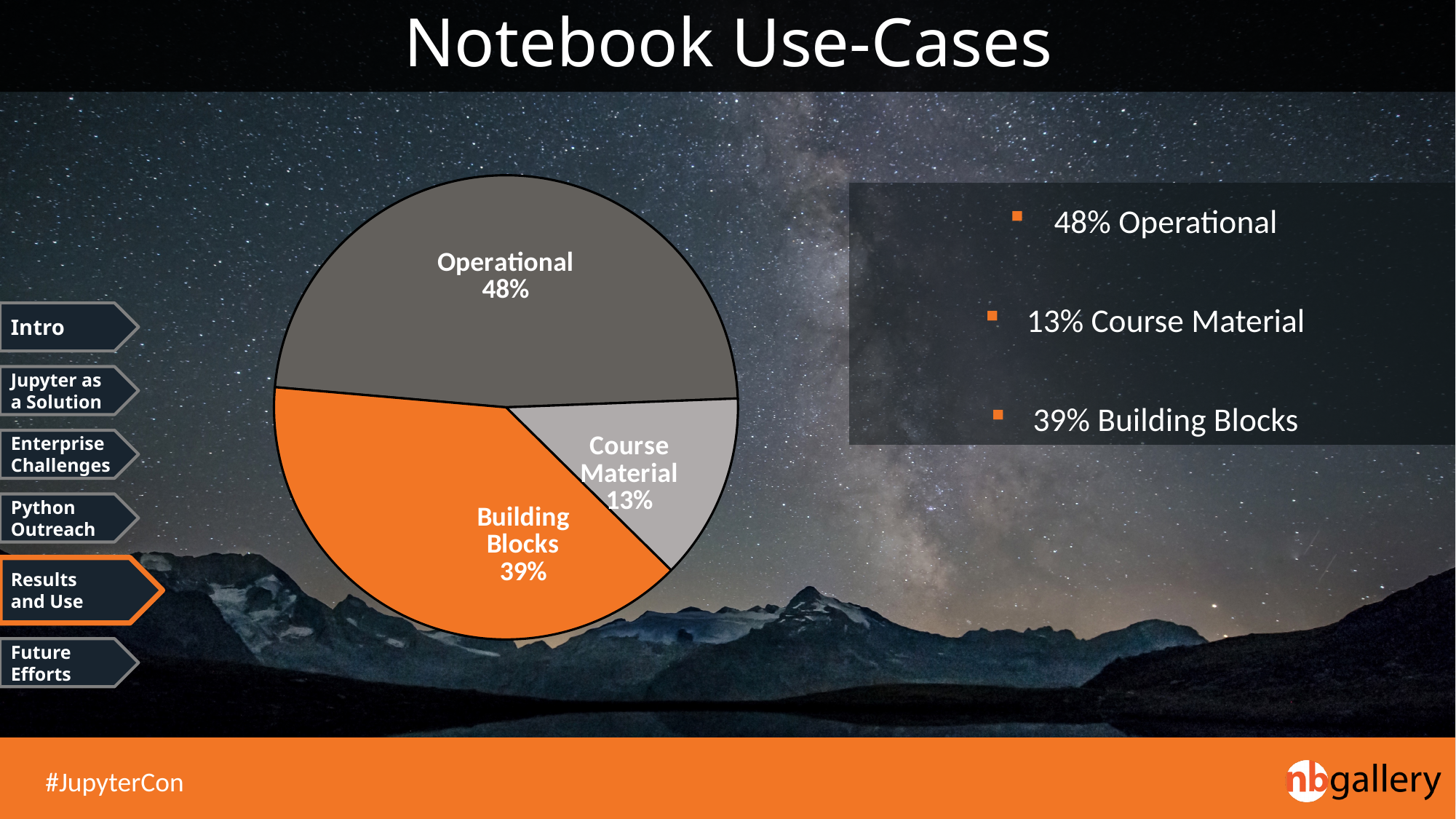
Which is larger, the Operational slice or the Building Blocks slice? Operational What is the difference in percentage points between Building Blocks and Course Material? 26 Which category has the largest slice of the pie? Operational How many slices does the pie chart have? 3 What colour is the Building Blocks slice? orange What is the difference in percentage points between Operational and Building Blocks? 9 What share of the pie does Course Material represent? 13% What share of the pie does Building Blocks represent? 39% What type of chart is shown on the slide? pie chart Which category has the smallest slice of the pie? Course Material What share of the pie does Operational represent? 48% What is the title of the slide containing the pie chart? Notebook Use-Cases